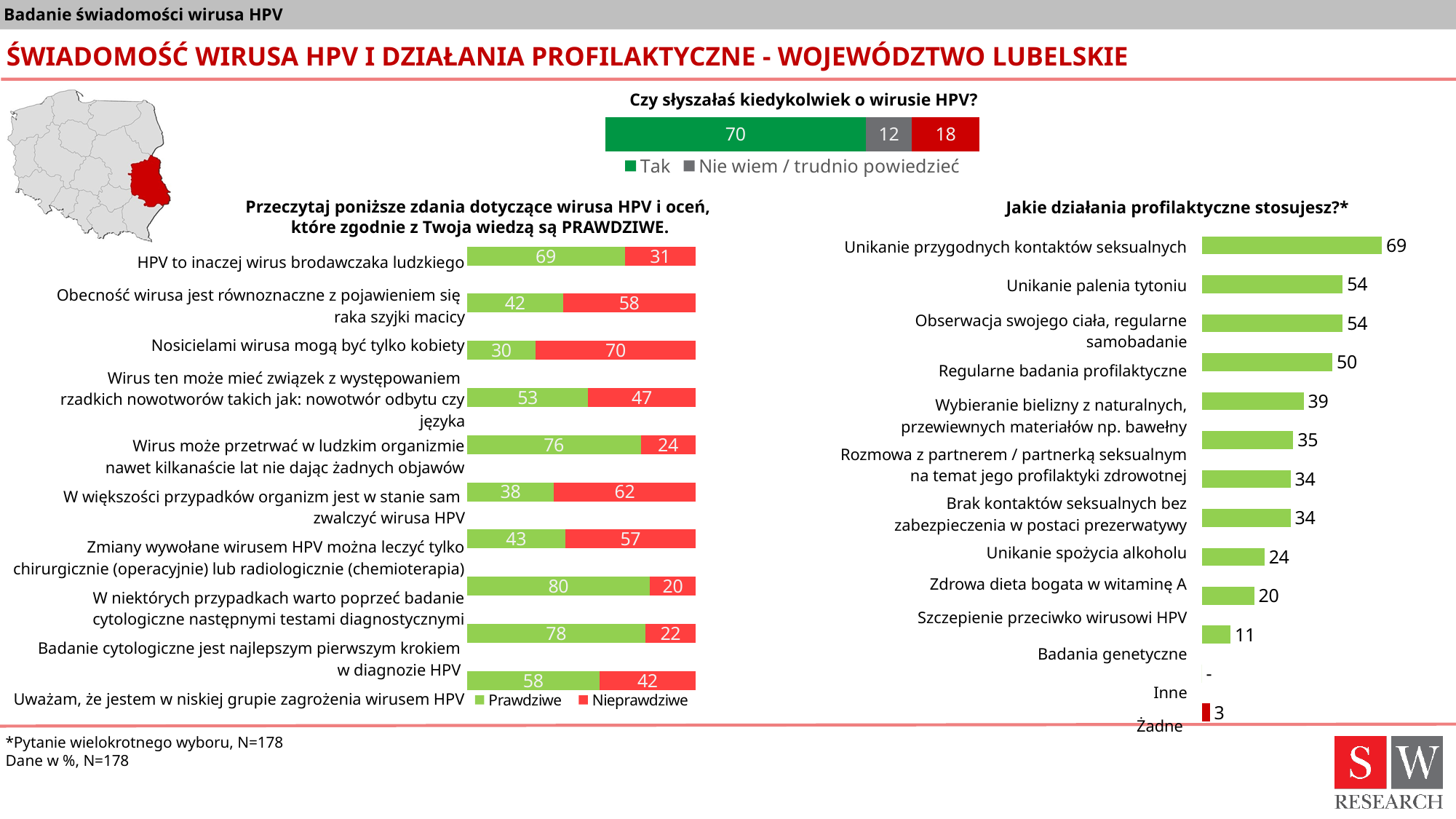
In the chart 'Przeczytaj poniższe zdania dotyczące wirusa HPV...', which is larger for 'Wirus może przetrwać w ludzkim organizmie nawet kilkanaście lat nie dając żadnych objawów': 'Prawdziwe' or 'Nieprawdziwe'? Prawdziwe In the chart 'Jakie działania profilaktyczne stosujesz?*', what is the value for 'Żadne'? 3 In the chart 'Czy słyszałaś kiedykolwiek o wirusie HPV?', what is the value for 'Tak'? 70 In the chart 'Czy słyszałaś kiedykolwiek o wirusie HPV?', what is the value for 'Nie wiem / trudnio powiedzieć'? 12 In the chart 'Jakie działania profilaktyczne stosujesz?*', what kind of chart is used? Bar chart In the chart 'Przeczytaj poniższe zdania dotyczące wirusa HPV...', what is the 'Nieprawdziwe' value for 'Nosicielami wirusa mogą być tylko kobiety'? 70 In the chart 'Jakie działania profilaktyczne stosujesz?*', what is the difference between 'Unikanie przygodnych kontaktów seksualnych' and 'Unikanie palenia tytoniu'? 15 In the chart 'Jakie działania profilaktyczne stosujesz?*', which category has the highest value? Unikanie przygodnych kontaktów seksualnych In the chart 'Przeczytaj poniższe zdania dotyczące wirusa HPV...', how many series does the legend list? 2 In the chart 'Przeczytaj poniższe zdania dotyczące wirusa HPV...', what is the 'Prawdziwe' value for 'HPV to inaczej wirus brodawczaka ludzkiego'? 69 In the chart 'Jakie działania profilaktyczne stosujesz?*', what is the value for 'Unikanie przygodnych kontaktów seksualnych'? 69 In the chart 'Czy słyszałaś kiedykolwiek o wirusie HPV?', what is the total of the three segments of the stacked bar? 100